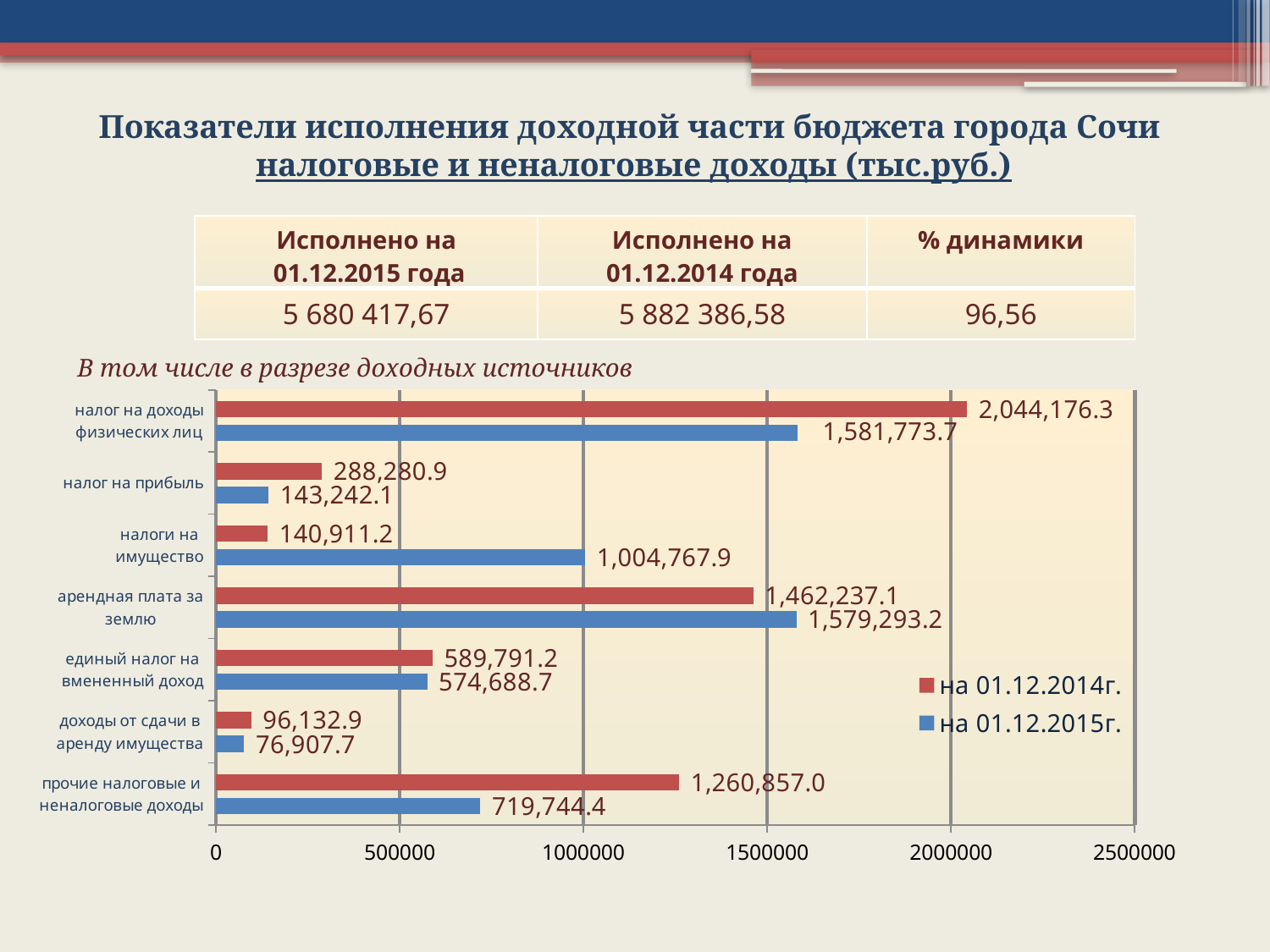
Which colour represents the series на 01.12.2015г. in the chart? blue What is the value for налоги на имущество for на 01.12.2015г.? 1,004,767.9 What is the value for доходы от сдачи в аренду имущества for на 01.12.2015г.? 76,907.7 What is the difference between the на 01.12.2014г. and на 01.12.2015г. values for налог на прибыль? 145,038.8 How many series does the chart legend list? 2 How many income source categories are shown in the chart? 7 Which category has the highest value for на 01.12.2014г.? налог на доходы физических лиц What is the value for налог на доходы физических лиц for на 01.12.2014г.? 2,044,176.3 Which category has the lowest value for на 01.12.2015г.? доходы от сдачи в аренду имущества For арендная плата за землю, which is larger: the value for на 01.12.2014г. or for на 01.12.2015г.? на 01.12.2015г. What is the difference between the на 01.12.2014г. and на 01.12.2015г. values for прочие налоговые и неналоговые доходы? 541,112.6 What type of chart is shown on the slide? bar chart